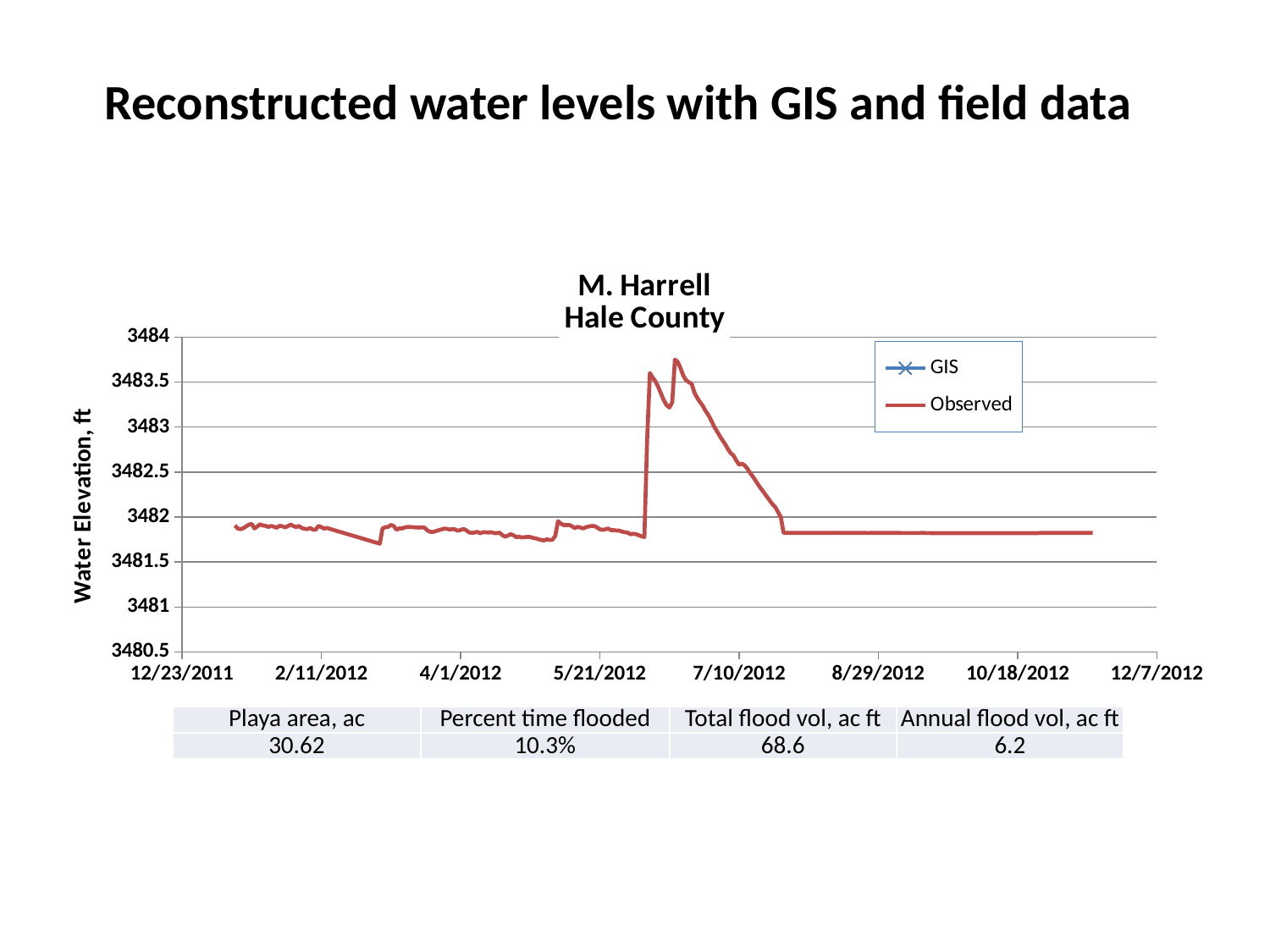
How many series does the legend of the chart list? 2 What are the two series named in the chart legend? GIS and Observed What is the Playa area in acres shown in the table below the chart? 30.62 What is the Total flood vol, ac ft shown in the table below the chart? 68.6 What is the title of the chart? M. Harrell Hale County How many date labels are shown on the x axis of the chart? 8 What kind of chart is shown on the slide? line chart Is the Observed water elevation at 2/11/2012 greater or less than 3482? less What is the Percent time flooded shown in the table below the chart? 10.3% Is the peak value of the Observed line greater or less than 3483.5? greater Does the Observed line rise or fall between its peak in June 2012 and 7/10/2012? fall Is the Observed water elevation at 10/18/2012 greater or less than 3482? less